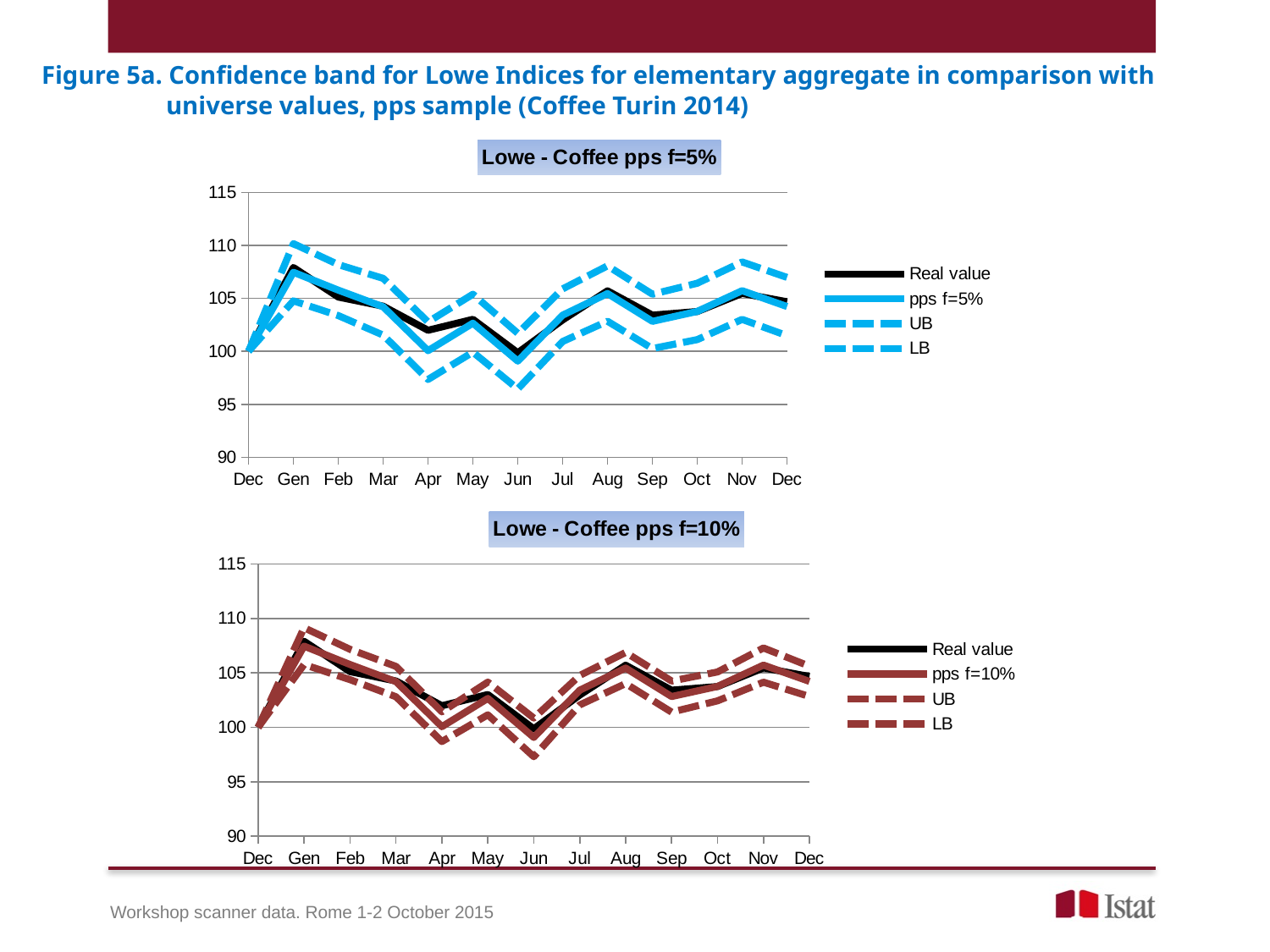
In the 'Lowe - Coffee pps f=5%' chart, does the Real value series rise or fall from Dec to Gen? rise What kind of chart is the 'Lowe - Coffee pps f=5%' chart? line chart In the 'Lowe - Coffee pps f=10%' chart, does the Real value series rise or fall from Gen to Apr? fall How many series does the legend of the 'Lowe - Coffee pps f=10%' chart list? 4 In the 'Lowe - Coffee pps f=10%' chart, is the UB value for Gen greater or less than 110? less In the 'Lowe - Coffee pps f=10%' chart, in which month does the Real value series reach its highest point? Gen What is the title of the lower chart on the slide? Lowe - Coffee pps f=10% How many months are shown on the x axis of the 'Lowe - Coffee pps f=5%' chart? 13 In the 'Lowe - Coffee pps f=5%' chart, is the Real value for Gen greater or less than 105? greater